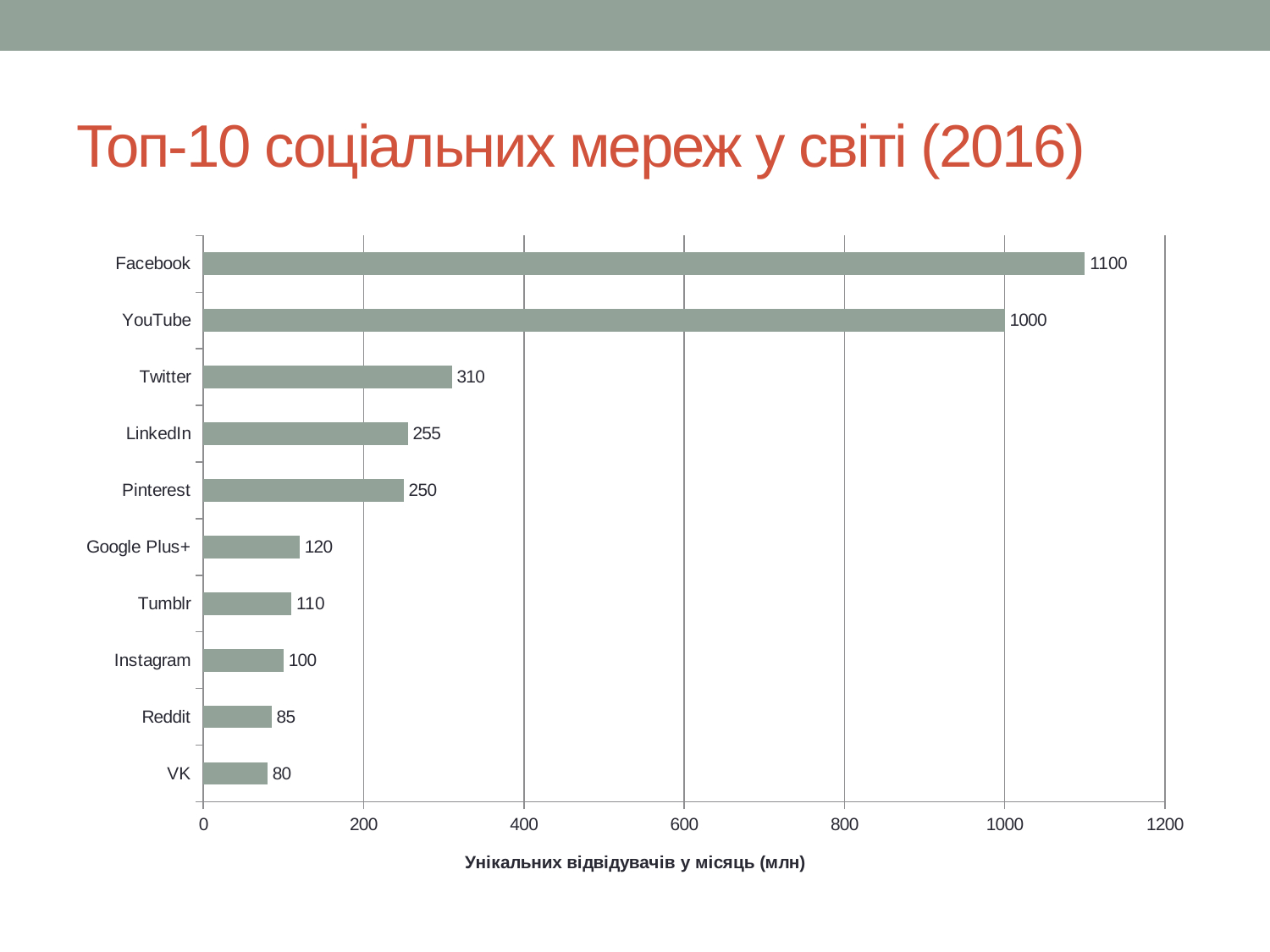
How many social networks are shown in the chart? 10 What is the value for Reddit? 85 Which is larger, the value for Google Plus+ or the value for Tumblr? Google Plus+ What is the difference between the values for Twitter and Pinterest? 60 What is the value for Facebook? 1100 Which social network has the highest value? Facebook What kind of chart is shown on the slide? bar chart What is the label of the horizontal axis? Унікальних відвідувачів у місяць (млн) Is the value for Twitter greater or less than 400? less What is the difference between the values for Facebook and YouTube? 100 Which social network has the lowest value? VK What is the value for LinkedIn? 255